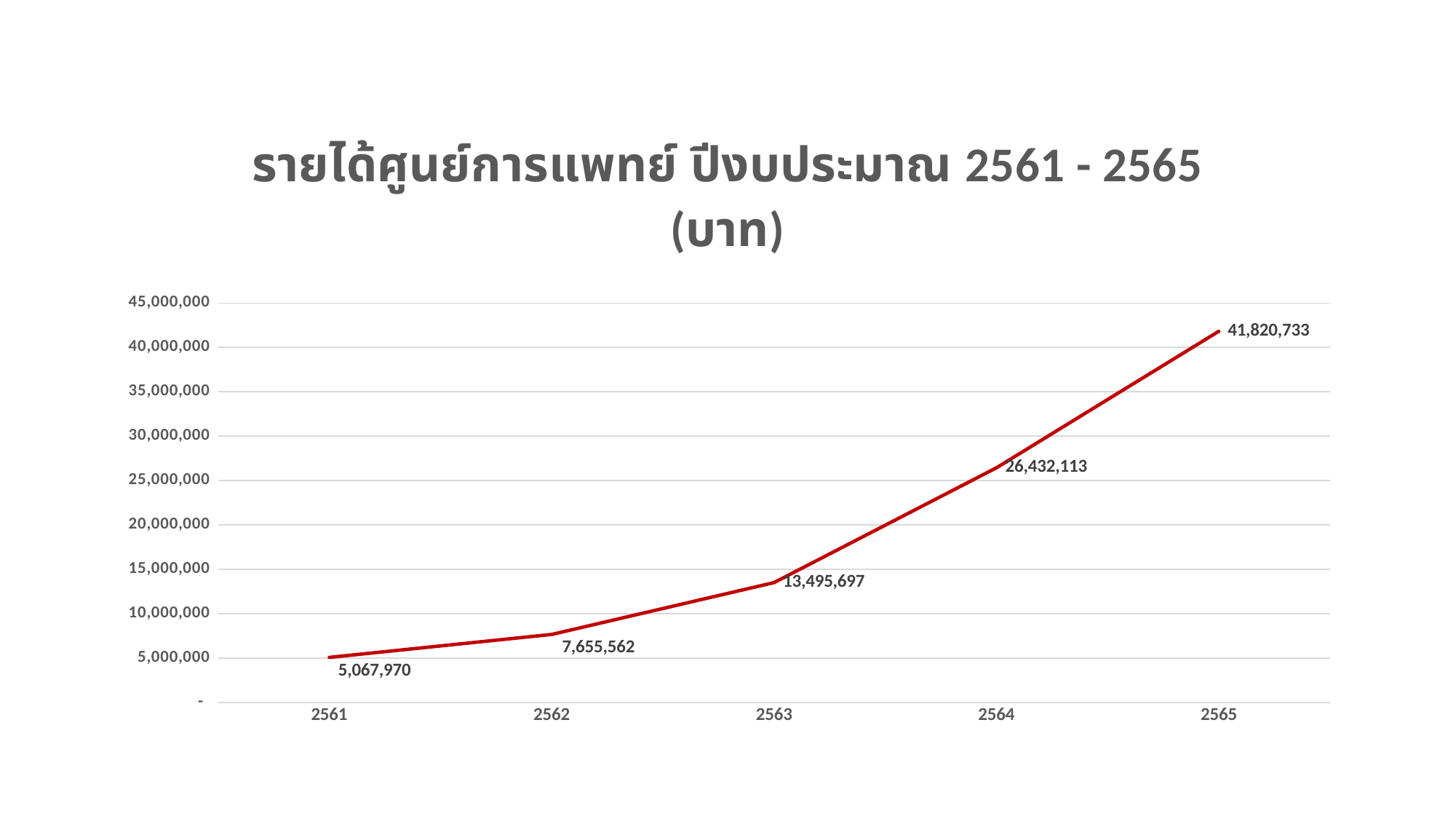
What is the value for 2561? 5,067,970 What is the difference between the values for 2562 and 2561? 2,587,592 What is the value for 2563? 13,495,697 Do the values rise or fall from 2561 to 2565? rise What kind of chart is shown on the slide? line chart What is the value for 2565? 41,820,733 Is the value for 2564 greater or less than 25,000,000? greater Which is larger, the value for 2563 or the value for 2564? 2564 How many years are plotted on the chart? 5 Which year has the lowest value? 2561 Which year has the highest value? 2565 What is the difference between the values for 2565 and 2564? 15,388,620